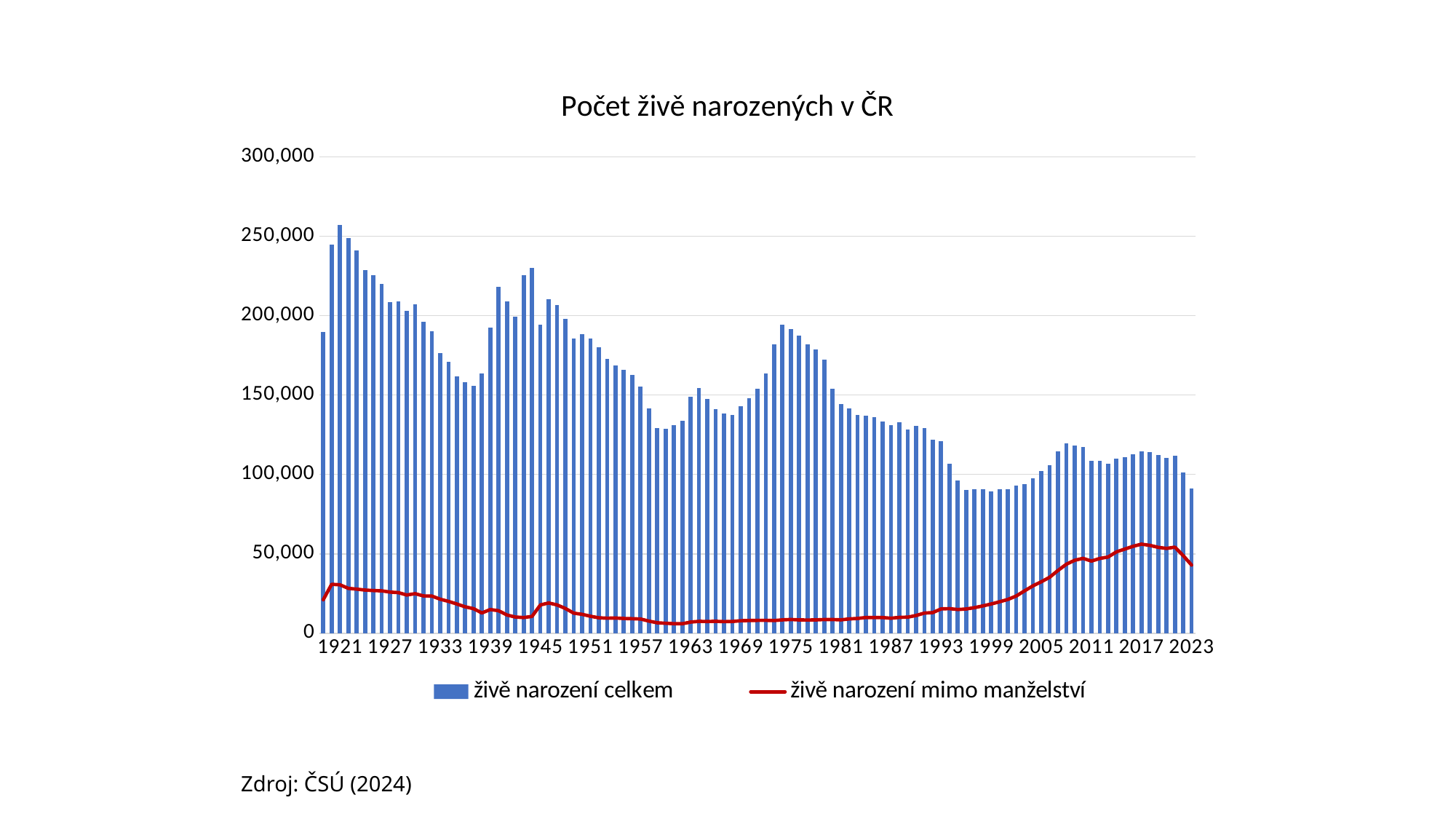
Is the value of živě narození mimo manželství for 2017 greater or less than 50,000? greater Is the value of živě narození celkem for 2023 greater or less than 100,000? less Does the value of živě narození mimo manželství rise or fall between 1993 and 2017? rise Is the value of živě narození celkem for 1975 greater or less than 150,000? greater Which series is drawn as a red line? živě narození mimo manželství What kind of chart is shown on the slide? A bar chart with a line series What is the title of the chart? Počet živě narozených v ČR How many series does the legend list? 2 Which year has the larger value of živě narození celkem, 1921 or 2023? 1921